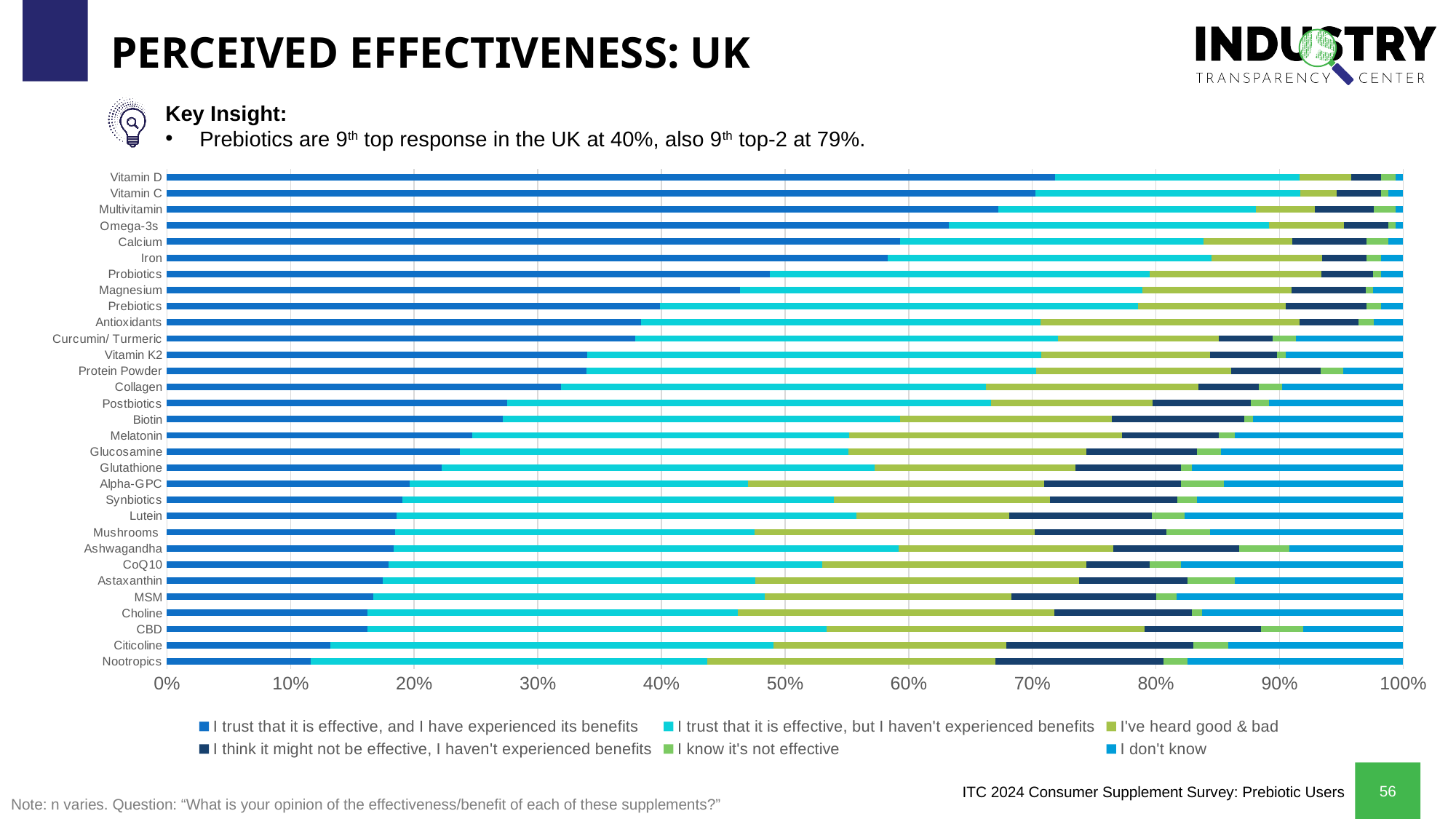
According to the slide, what is the share of Prebiotics for 'I trust that it is effective, and I have experienced its benefits'? 40% How many series does the chart legend list? 6 Which supplement has the lowest share for 'I trust that it is effective, and I have experienced its benefits'? Nootropics Is the 'I trust that it is effective, and I have experienced its benefits' value for Magnesium greater or less than 50%? less What kind of chart is shown on the slide? Stacked bar chart Which supplement has the highest share for 'I trust that it is effective, and I have experienced its benefits'? Vitamin D Does the 'I trust that it is effective, and I have experienced its benefits' share rise or fall going down the list from Vitamin D to Nootropics? Fall How many supplement categories are listed on the chart? 31 Which has a larger 'I trust that it is effective, and I have experienced its benefits' share, Vitamin C or Citicoline? Vitamin C What is the title of the chart slide? PERCEIVED EFFECTIVENESS: UK Is the 'I trust that it is effective, and I have experienced its benefits' value for Nootropics greater or less than 20%? less Is the 'I trust that it is effective, and I have experienced its benefits' value for Vitamin D greater or less than 60%? greater